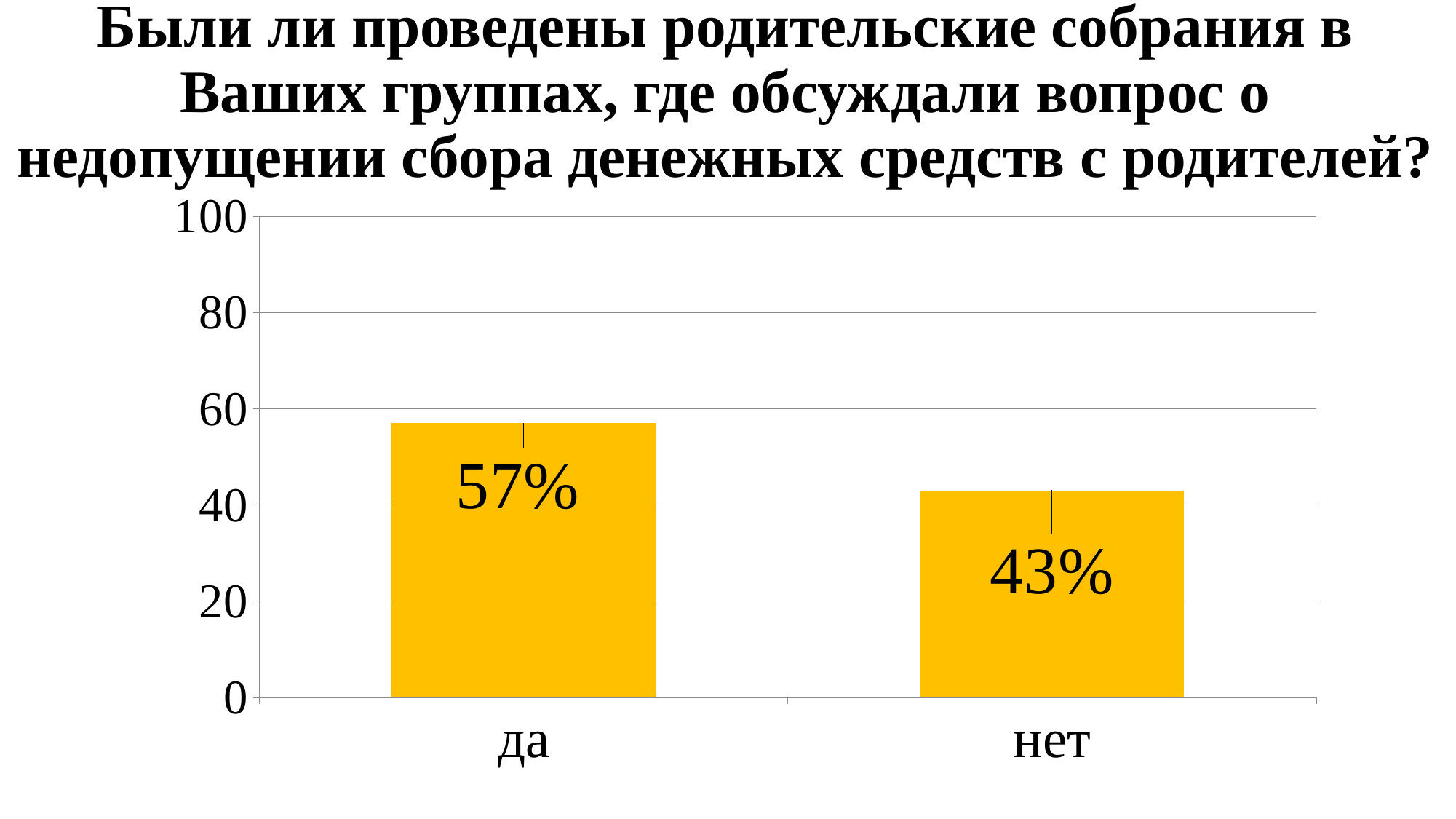
What is the value for "нет"? 43% Is the value for "да" greater or less than 40? greater Is the value for "нет" greater or less than 60? less What colour are the bars in the chart? yellow Which is larger, the value for "да" or the value for "нет"? да What kind of chart is shown on the slide? bar chart Which category has the lowest value? нет Which category has the highest value? да What is the maximum value shown on the vertical axis? 100 What is the difference between the values for "да" and "нет"? 14% How many categories are shown on the x axis? 2 What is the value for "да"? 57%